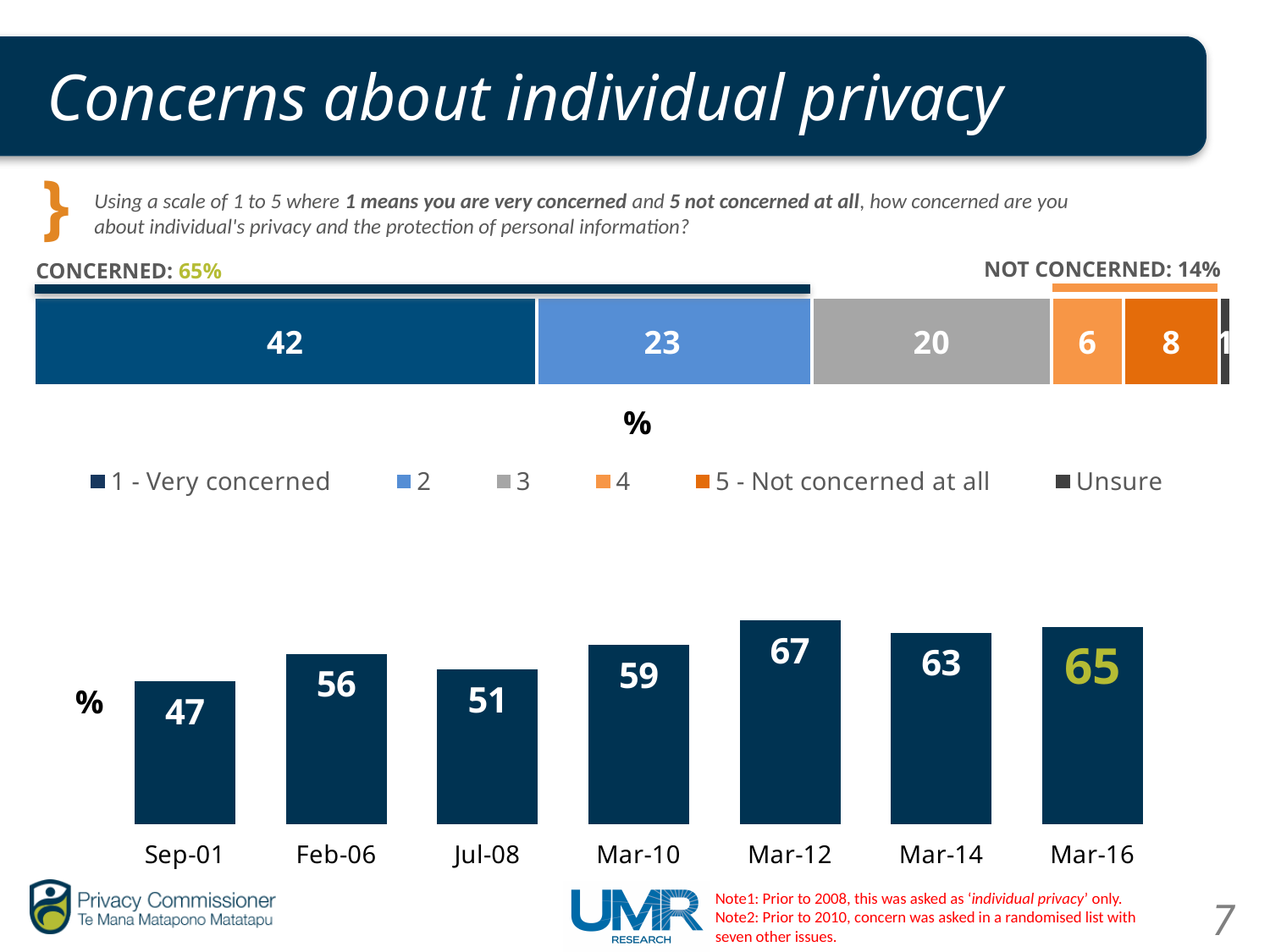
In the bottom bar chart, what is the value for Sep-01? 47 In the bottom bar chart, how many time points are plotted? 7 In the bottom bar chart, which time point has the lowest value? Sep-01 In the bottom bar chart, what is the value for Mar-12? 67 In the bottom bar chart, which time point has the highest value? Mar-12 How many series does the legend of the top stacked bar chart list? 6 In the top stacked bar chart, what is the value for the '3' segment? 20 In the bottom bar chart, what is the difference between the values for Mar-16 and Mar-14? 2 In the top stacked bar chart, which of the segments '2' or '4' is larger? 2 In the top stacked bar chart, what percentage of respondents answered '1 - Very concerned'? 42 In the top stacked bar chart, what is the difference between the '1 - Very concerned' and '2' segments? 19 In the top stacked bar chart, what is the value for '5 - Not concerned at all'? 8